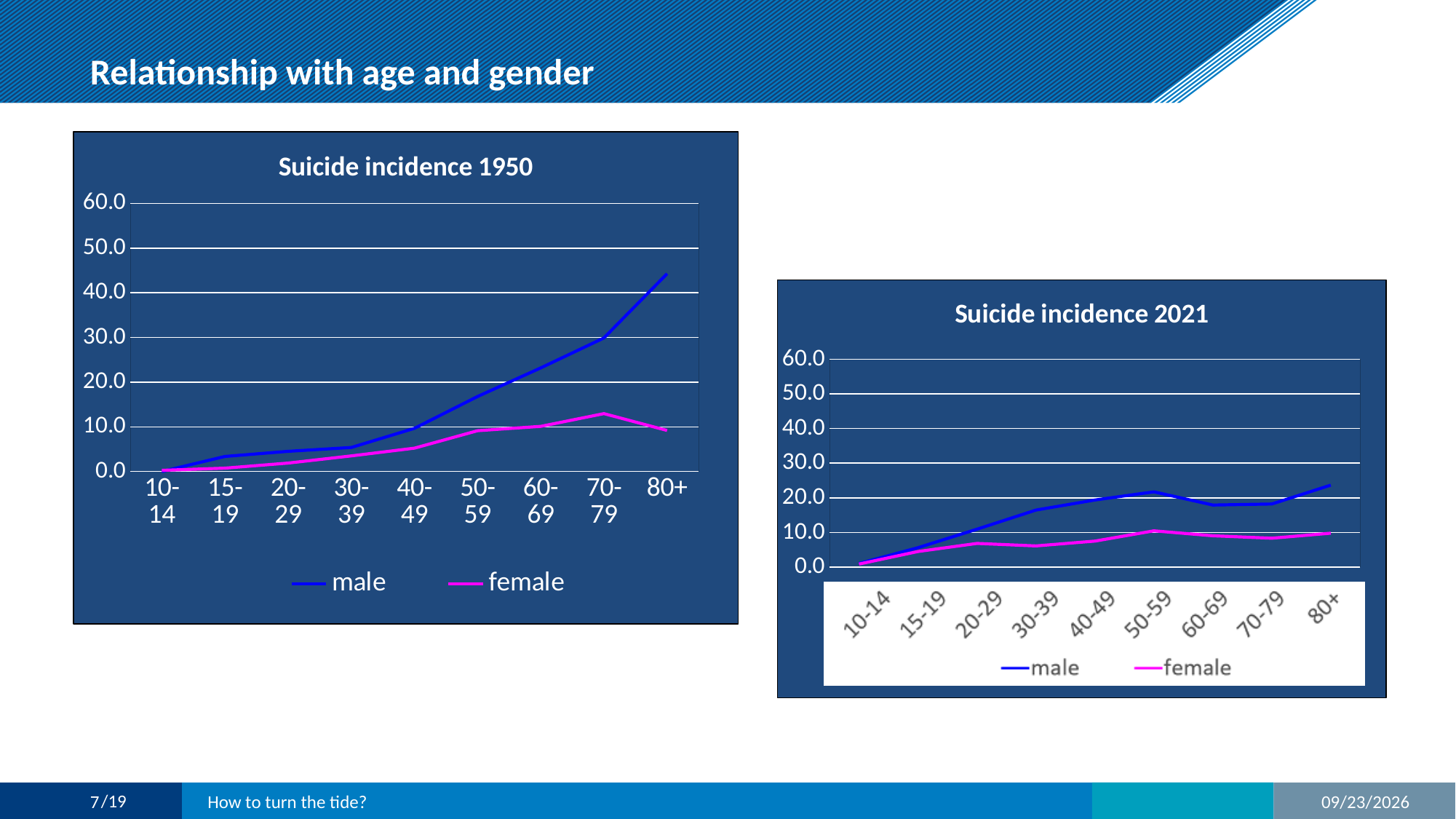
In "Suicide incidence 1950", is the male value for 80+ greater or less than 40? greater In "Suicide incidence 1950", which is larger at 80+, the male value or the female value? male In "Suicide incidence 2021", is the male value for 80+ greater or less than 20? greater How many age categories are shown on the x axis of "Suicide incidence 1950"? 9 Which colour is used for the female series in "Suicide incidence 1950"? magenta How many series does the legend of "Suicide incidence 2021" list? 2 In "Suicide incidence 2021", which age group has the lowest male value? 10-14 In "Suicide incidence 1950", which age group has the highest female value? 70-79 In "Suicide incidence 1950", is the female value for 70-79 greater or less than 10? greater What kind of chart is "Suicide incidence 1950"? line chart In "Suicide incidence 2021", which age group has the highest female value? 50-59 In "Suicide incidence 1950", which age group has the highest male value? 80+